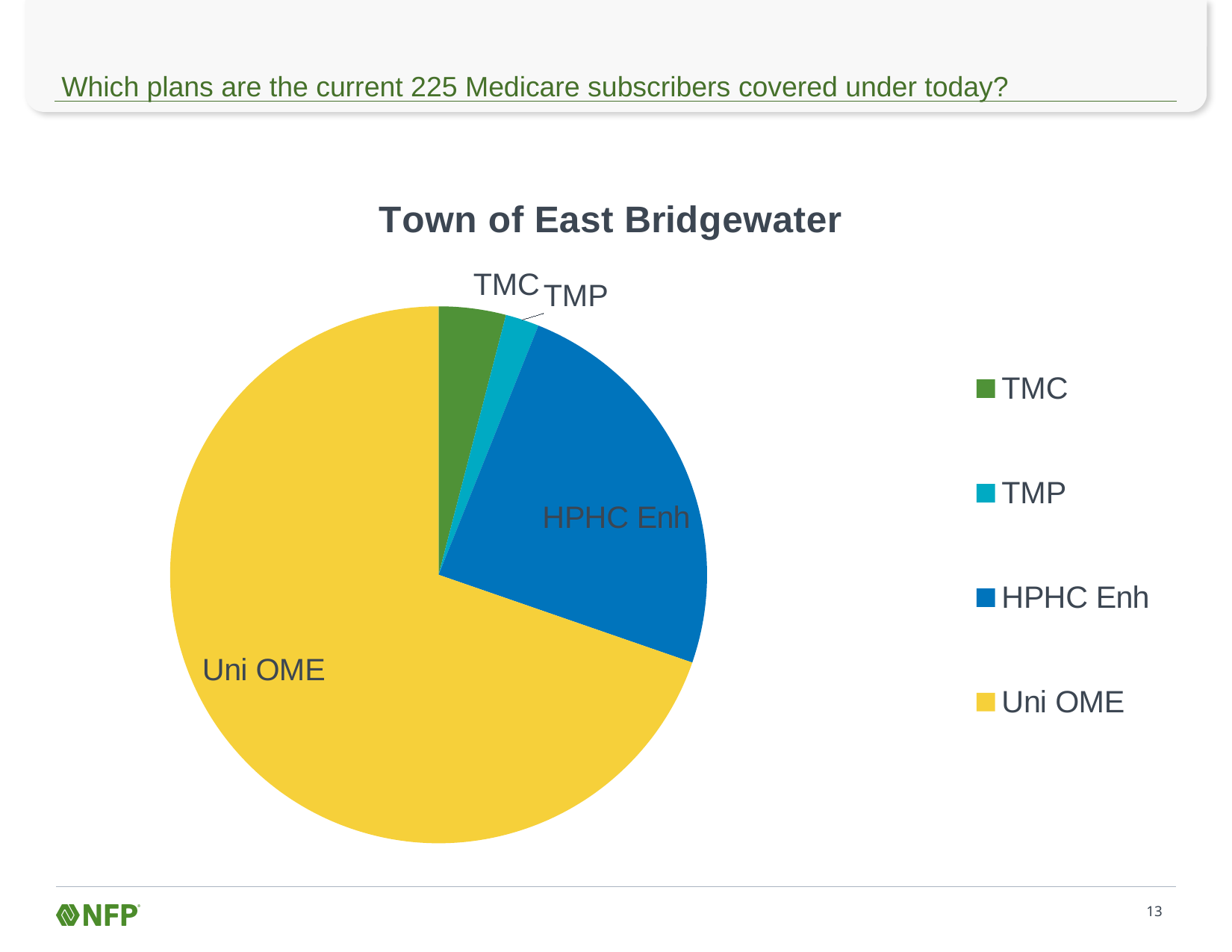
Which plan has the second-largest slice of the pie? HPHC Enh What colour is the Uni OME slice? Yellow Which slice is larger, Uni OME or HPHC Enh? Uni OME Which slice is larger, TMC or TMP? TMC Does the Uni OME slice take up more or less than half of the pie? More How many slices does the pie chart have? 4 What kind of chart is shown on the slide? Pie chart Which plan has the largest slice of the pie? Uni OME Which slice is larger, HPHC Enh or TMC? HPHC Enh Which plan has the smallest slice of the pie? TMP What is the title of the chart? Town of East Bridgewater How many entries does the legend list? 4